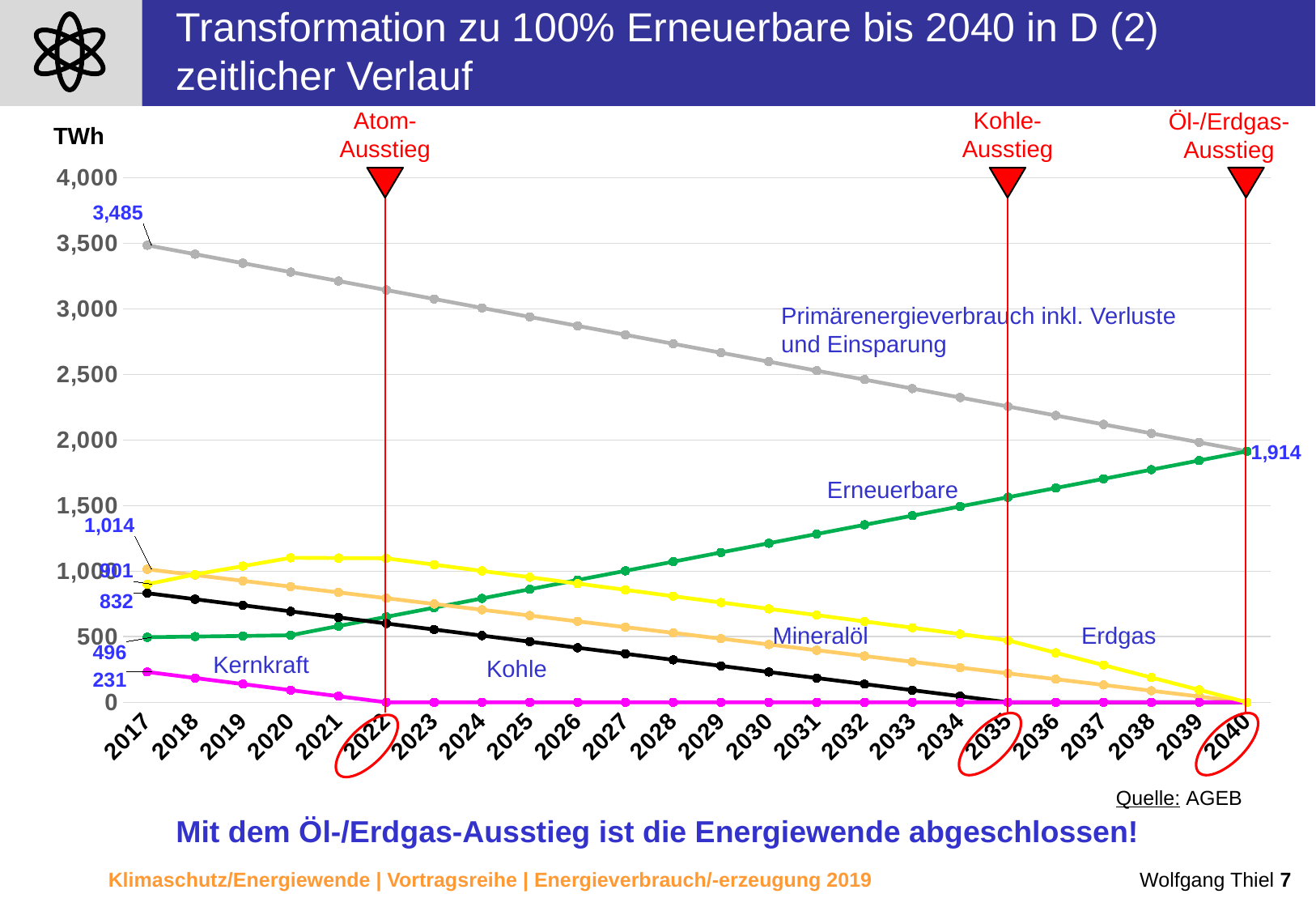
In 2017, which is larger: Mineralöl or Kohle? Mineralöl What is the value for Kernkraft in 2017? 231 What kind of chart is shown on the slide? line chart How many years are shown on the x axis? 24 By how much does Erneuerbare increase from 2017 to 2040? 1,418 What is the value of Primärenergieverbrauch inkl. Verluste und Einsparung in 2017? 3,485 What is the value for Kohle in 2017? 832 Is the value for Erneuerbare in 2030 greater or less than 1,000? greater Does the Primärenergieverbrauch line rise or fall from 2017 to 2040? fall In which year is the Kohle-Ausstieg marked on the chart? 2035 What is the value for Erneuerbare in 2017? 496 What value does the Erneuerbare line reach in 2040? 1,914